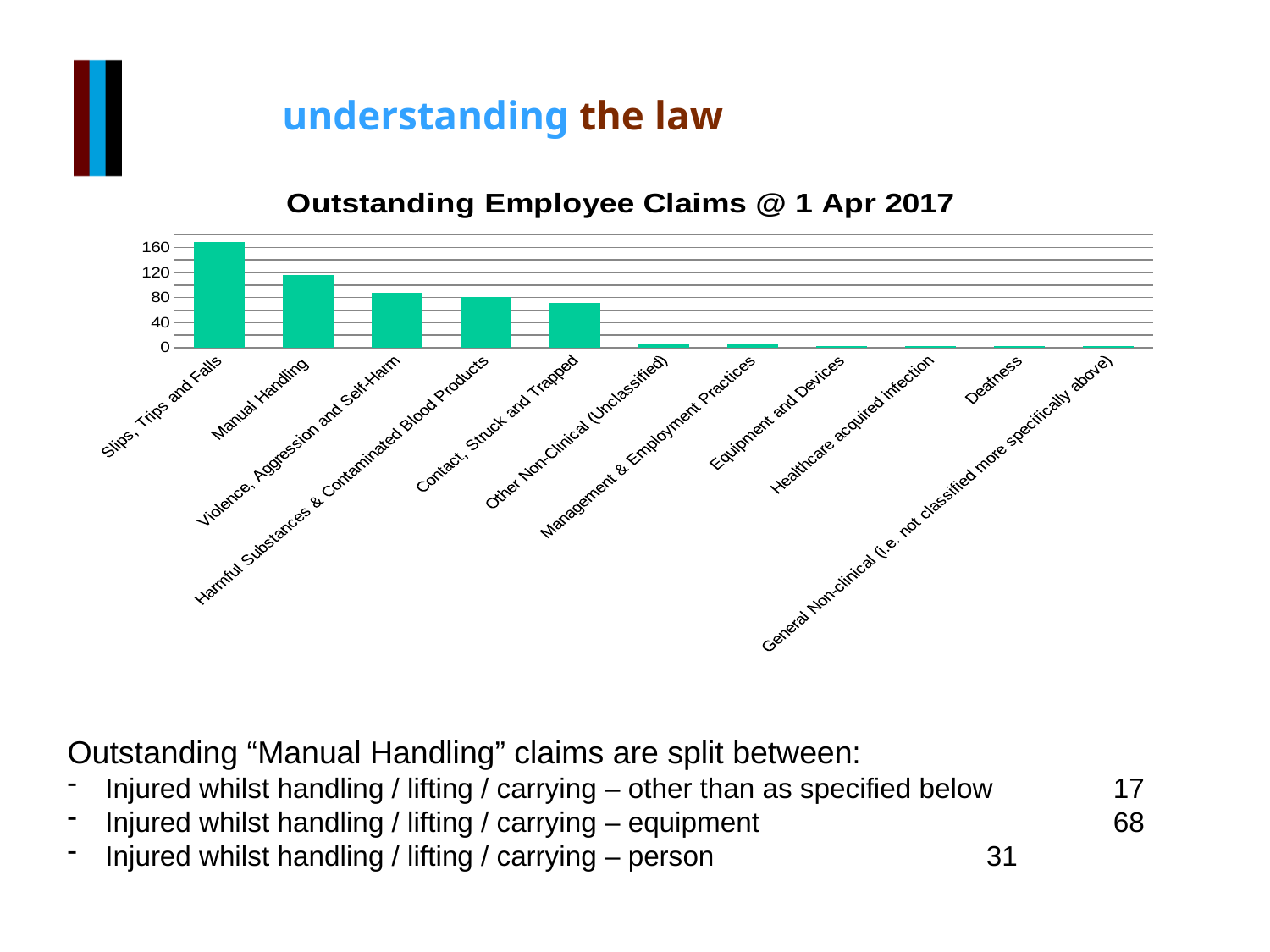
Is the value for Other Non-Clinical (Unclassified) greater or less than 40? less What kind of chart is shown on the slide? Bar chart Do the values rise or fall moving from left to right along the x axis? Fall Which has more outstanding claims, Manual Handling or Contact, Struck and Trapped? Manual Handling Is the value for Manual Handling greater or less than 80? greater Which has more outstanding claims, Slips, Trips and Falls or Manual Handling? Slips, Trips and Falls How many categories are plotted on the chart? 11 Is the value for Contact, Struck and Trapped greater or less than 80? less Which category has the highest number of outstanding claims? Slips, Trips and Falls What is the title of the chart? Outstanding Employee Claims @ 1 Apr 2017